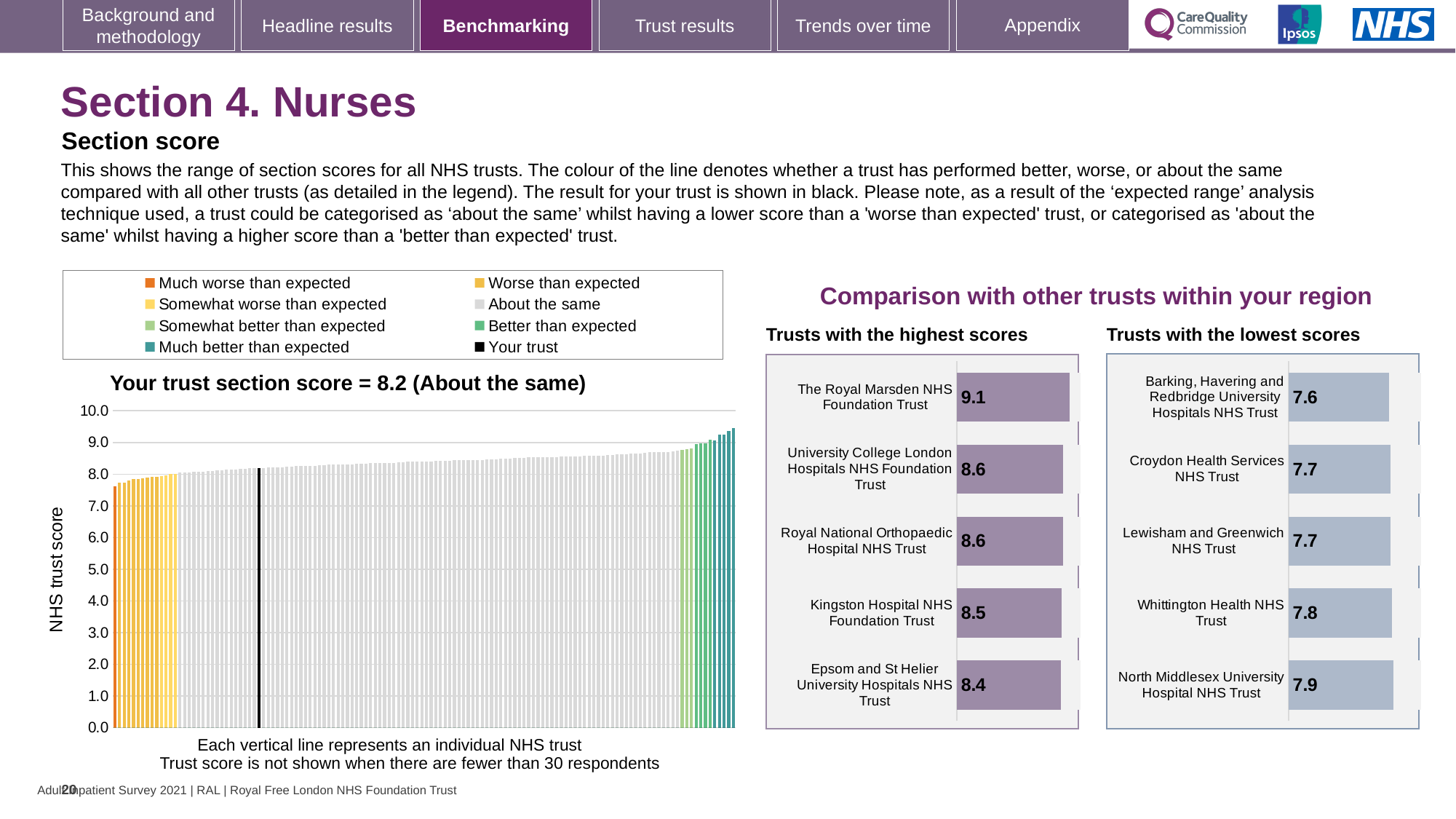
How many entries does the legend above the main chart on the left list? 8 On the main chart on the left, do the values rise or fall from left to right along the x axis? rise On the 'Trusts with the highest scores' chart, what is the score for The Royal Marsden NHS Foundation Trust? 9.1 On the 'Trusts with the highest scores' chart, which trust has the highest score? The Royal Marsden NHS Foundation Trust On the 'Trusts with the lowest scores' chart, what is the score for Barking, Havering and Redbridge University Hospitals NHS Trust? 7.6 On the 'Trusts with the lowest scores' chart, which has the larger score: Whittington Health NHS Trust or Croydon Health Services NHS Trust? Whittington Health NHS Trust On the 'Trusts with the highest scores' chart, what is the score for Kingston Hospital NHS Foundation Trust? 8.5 On the 'Trusts with the lowest scores' chart, which trust has the lowest score? Barking, Havering and Redbridge University Hospitals NHS Trust On the main chart on the left, is the value of the tallest bar greater or less than 9.0? greater On the 'Trusts with the highest scores' chart, what is the difference between the scores of The Royal Marsden NHS Foundation Trust and Epsom and St Helier University Hospitals NHS Trust? 0.7 How many trusts are shown on the 'Trusts with the lowest scores' chart? 5 On the main chart on the left, what is your trust's section score? 8.2